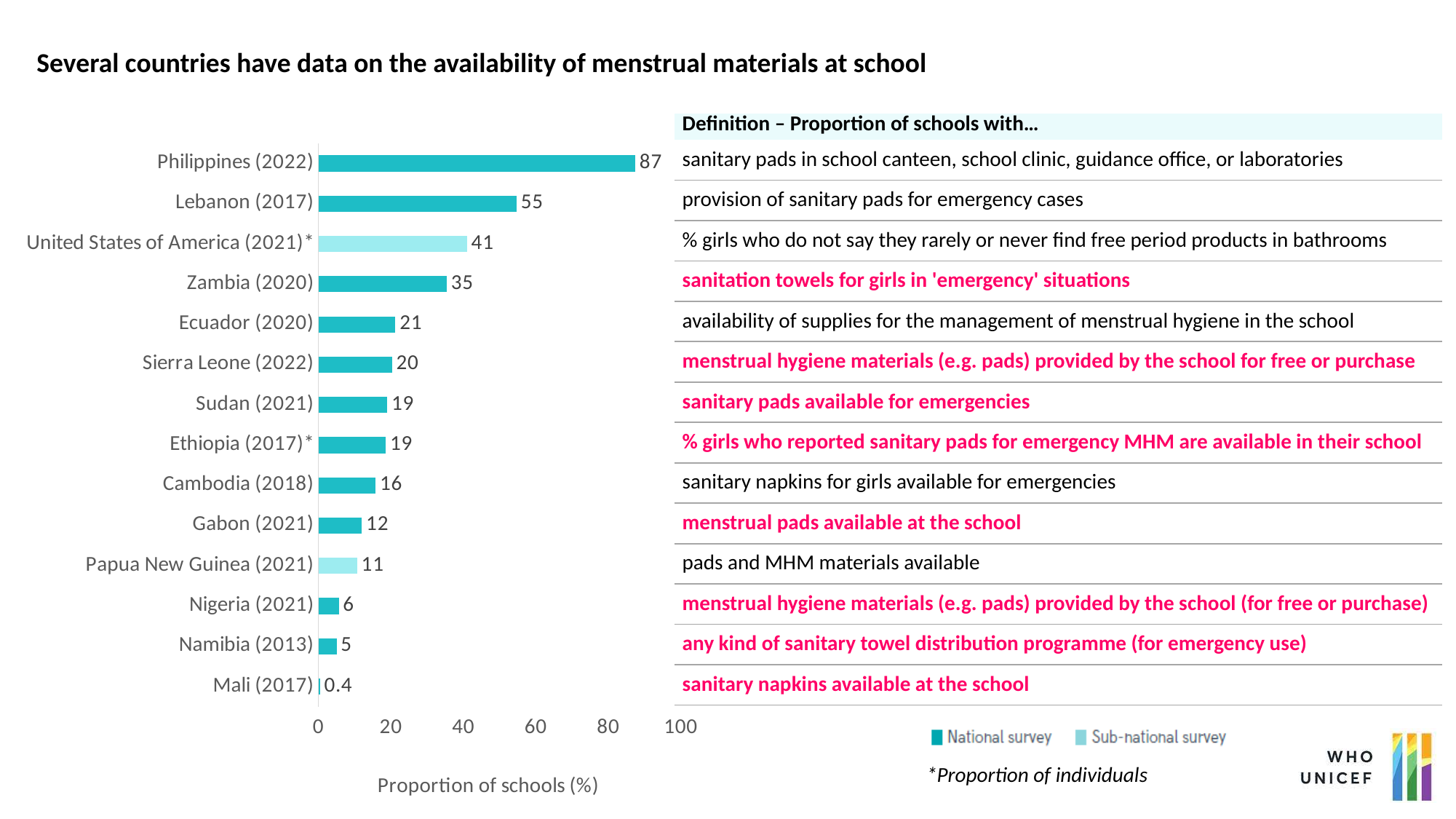
What is the value for Mali (2017)? 0.4 Which two countries are shown with the Sub-national survey colour? United States of America (2021) and Papua New Guinea (2021) What is the difference between the values for Philippines (2022) and Lebanon (2017)? 32 How many series does the legend list? 2 Which country has the lowest proportion of schools? Mali (2017) Which is larger, the value for Ecuador (2020) or Cambodia (2018)? Ecuador (2020) What is the label of the x axis? Proportion of schools (%) Which country has the highest proportion of schools? Philippines (2022) What kind of chart is shown on the slide? Bar chart What is the value for Zambia (2020)? 35 What is the value for Philippines (2022)? 87 How many countries are shown in the bar chart? 14